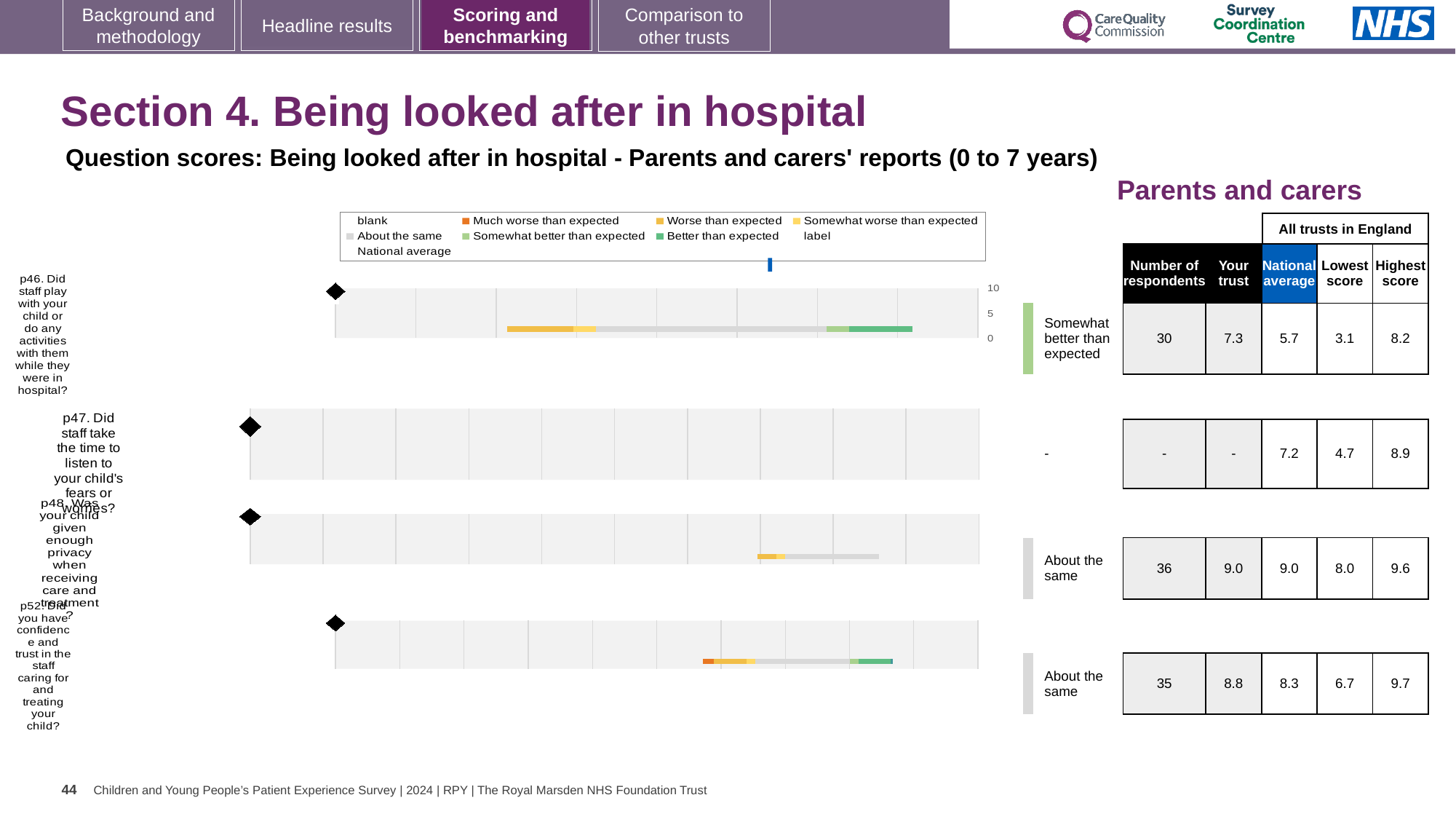
What kind of chart is used to show the question scores on this slide? bar chart What benchmark category is shown next to the chart for p46 (Did staff play with your child or do any activities with them while they were in hospital?)? Somewhat better than expected In the table beside the charts, what is the 'Your trust' score for p46? 7.3 In the table beside the charts, what is the Lowest score for p47 (Did staff take the time to listen to your child's fears or worries?)? 4.7 How many entries does the chart legend list? 9 What is the difference between the 'Your trust' score and the National average for p46? 1.6 In the table beside the charts, what is the National average for p46? 5.7 How many survey questions (chart rows) are shown on the slide? 4 In the table beside the charts, what is the Number of respondents for p48 (Was your child given enough privacy when receiving care and treatment?)? 36 What colour is the legend marker for 'Much worse than expected'? orange For p52, which is larger: the 'Your trust' score or the National average? Your trust In the table beside the charts, what is the Highest score for p52 (Did you have confidence and trust in the staff caring for and treating your child?)? 9.7